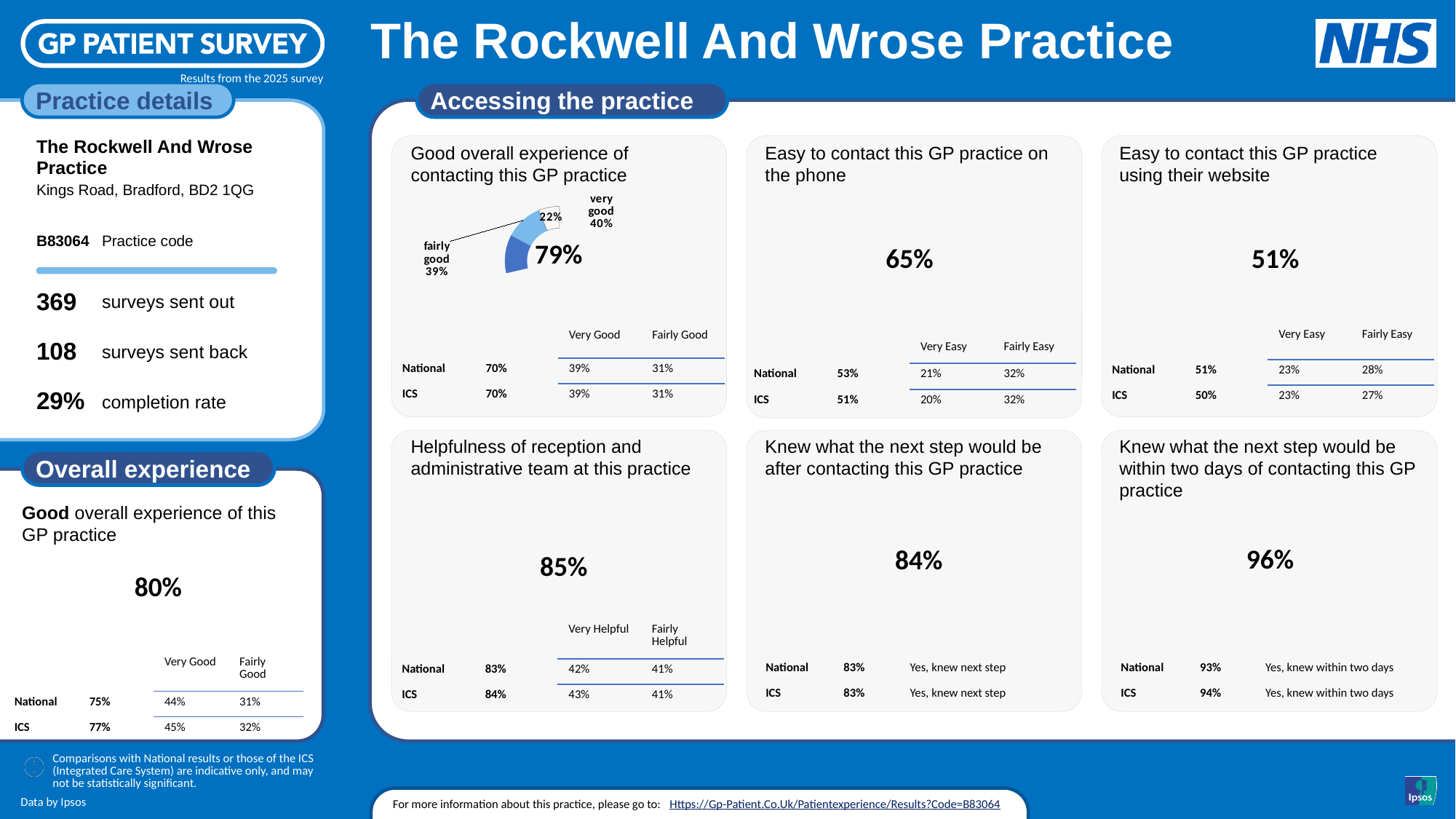
In the 'Good overall experience of contacting this GP practice' chart, what is the difference between the 'very good' and 'fairly good' percentages? 1 percentage point What kind of chart is shown in the 'Good overall experience of contacting this GP practice' panel? Doughnut (pie) chart In the 'Good overall experience of contacting this GP practice' chart, which labelled slice is the smallest? The 22% slice What value is printed in the centre of the 'Good overall experience of contacting this GP practice' doughnut chart? 79% In the 'Good overall experience of contacting this GP practice' chart, what is the percentage shown for the third, unlabelled slice? 22% In the 'Good overall experience of contacting this GP practice' chart, is the 'very good' slice greater or less than 50%? less In the 'Good overall experience of contacting this GP practice' chart, what percentage is labelled 'very good'? 40% What is the title of the panel containing the doughnut chart on this slide? Good overall experience of contacting this GP practice In the 'Good overall experience of contacting this GP practice' chart, what percentage is labelled 'fairly good'? 39% In the 'Good overall experience of contacting this GP practice' chart, which is larger: 'very good' or 'fairly good'? very good How many slices does the 'Good overall experience of contacting this GP practice' doughnut chart have? 3 In the 'Good overall experience of contacting this GP practice' chart, what do the 'very good' and 'fairly good' slices add up to? 79%